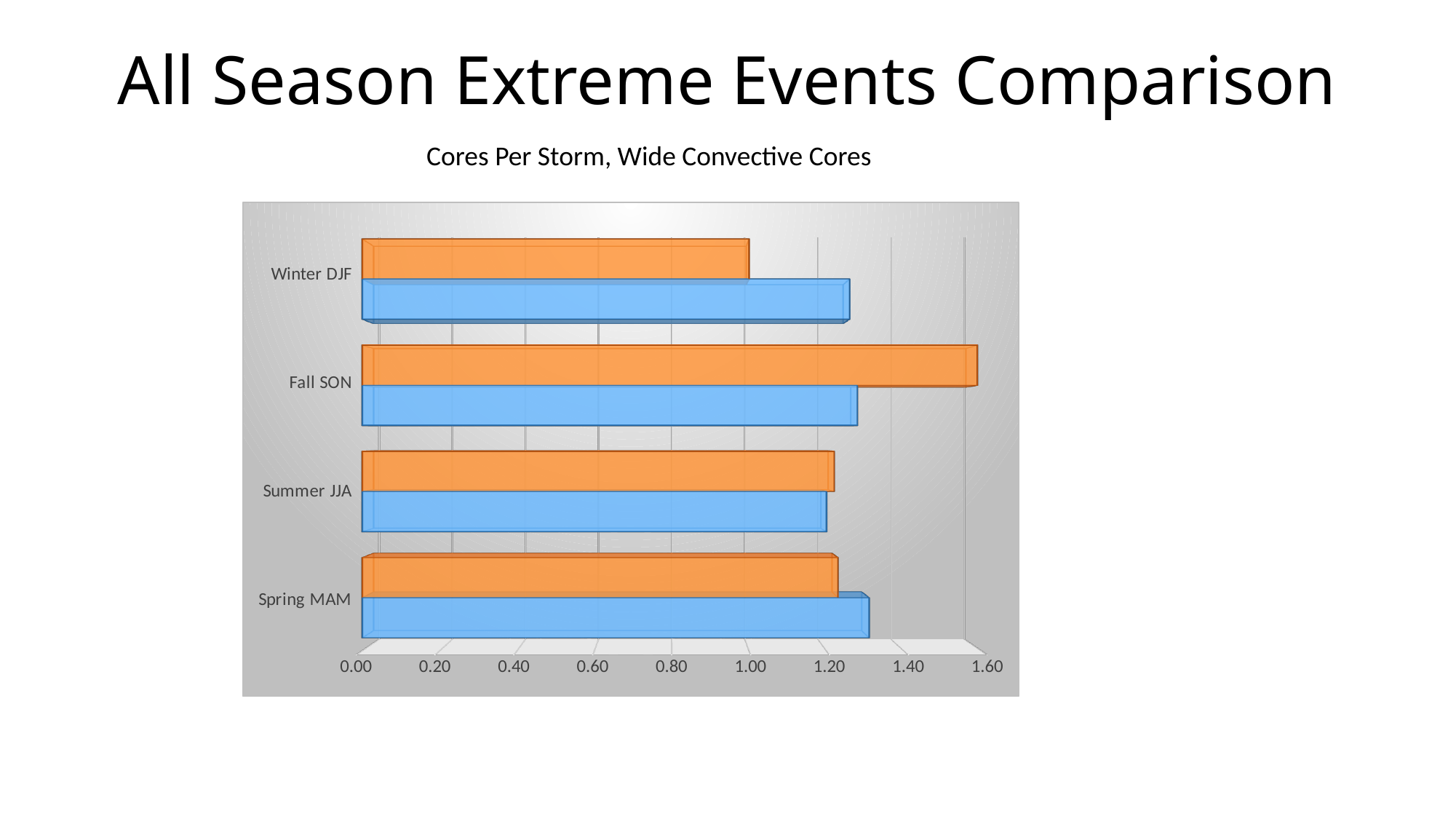
Is the blue bar for Spring MAM greater or less than 1.40? less Which season has the shortest orange bar? Winter DJF Is the orange bar for Fall SON greater or less than 1.40? greater What is the title of the chart? Cores Per Storm, Wide Convective Cores What two colours are used for the bars in the chart? orange and blue Is the orange bar for Winter DJF greater or less than 1.20? less For Fall SON, which bar is longer, the orange bar or the blue bar? orange What kind of chart is shown on the slide? bar chart Which season has the longest orange bar? Fall SON How many seasons (categories) are shown on the chart? 4 For Winter DJF, which bar is longer, the orange bar or the blue bar? blue